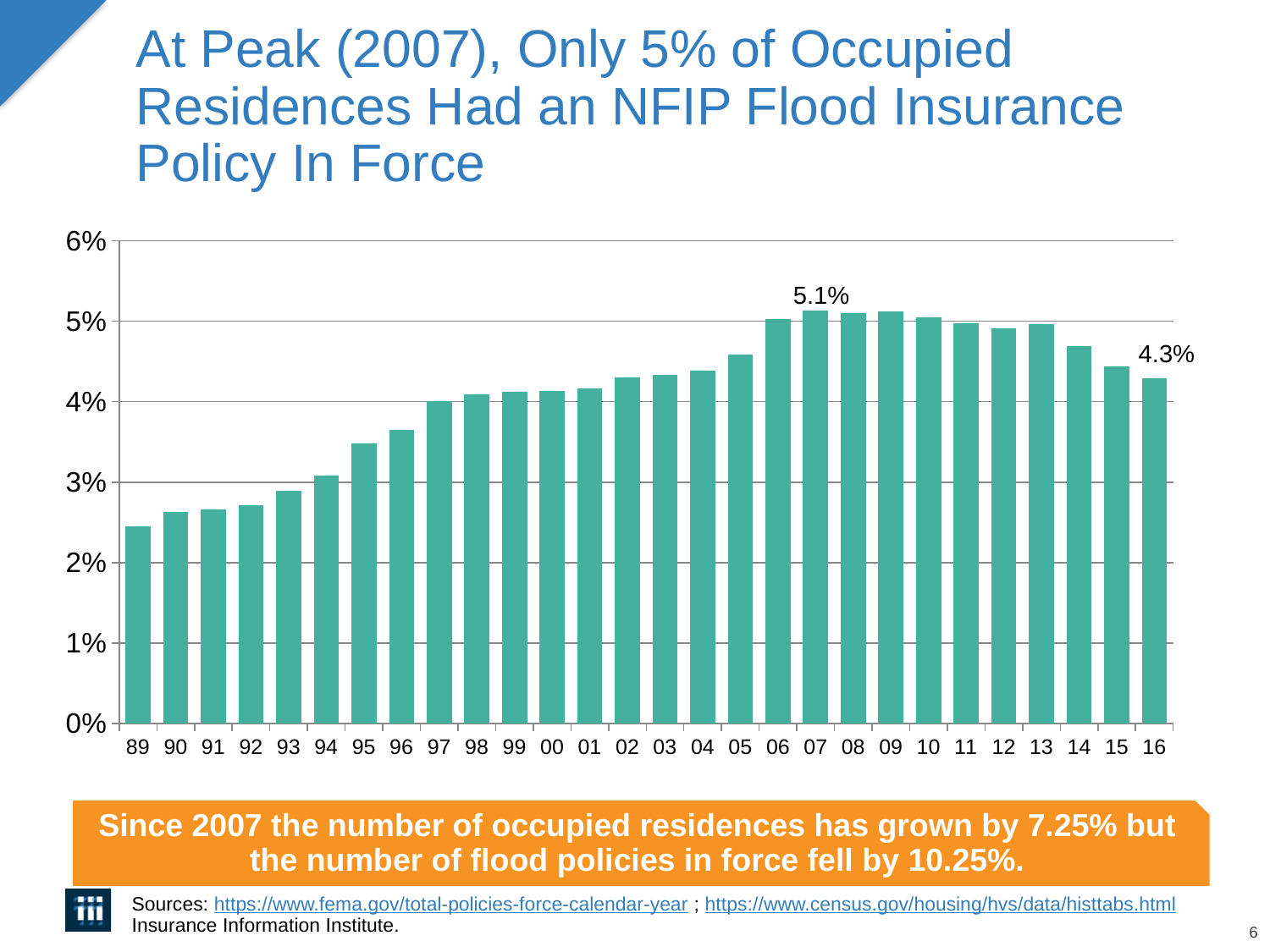
Which is larger, the value for 89 or the value for 16? 16 Which year has the highest bar? 07 What kind of chart is shown on the slide? bar chart Is the value for 14 greater or less than 5%? less How many years (bars) are shown on the x axis? 28 Do the values generally rise or fall from 89 to 07? rise Is the value for 05 greater or less than 4%? greater What is the value shown for 07? 5.1% What is the value shown for 16? 4.3% Which year has the lowest bar? 89 Is the value for 89 greater or less than 3%? less What is the difference between the value for 07 and the value for 16? 0.8%